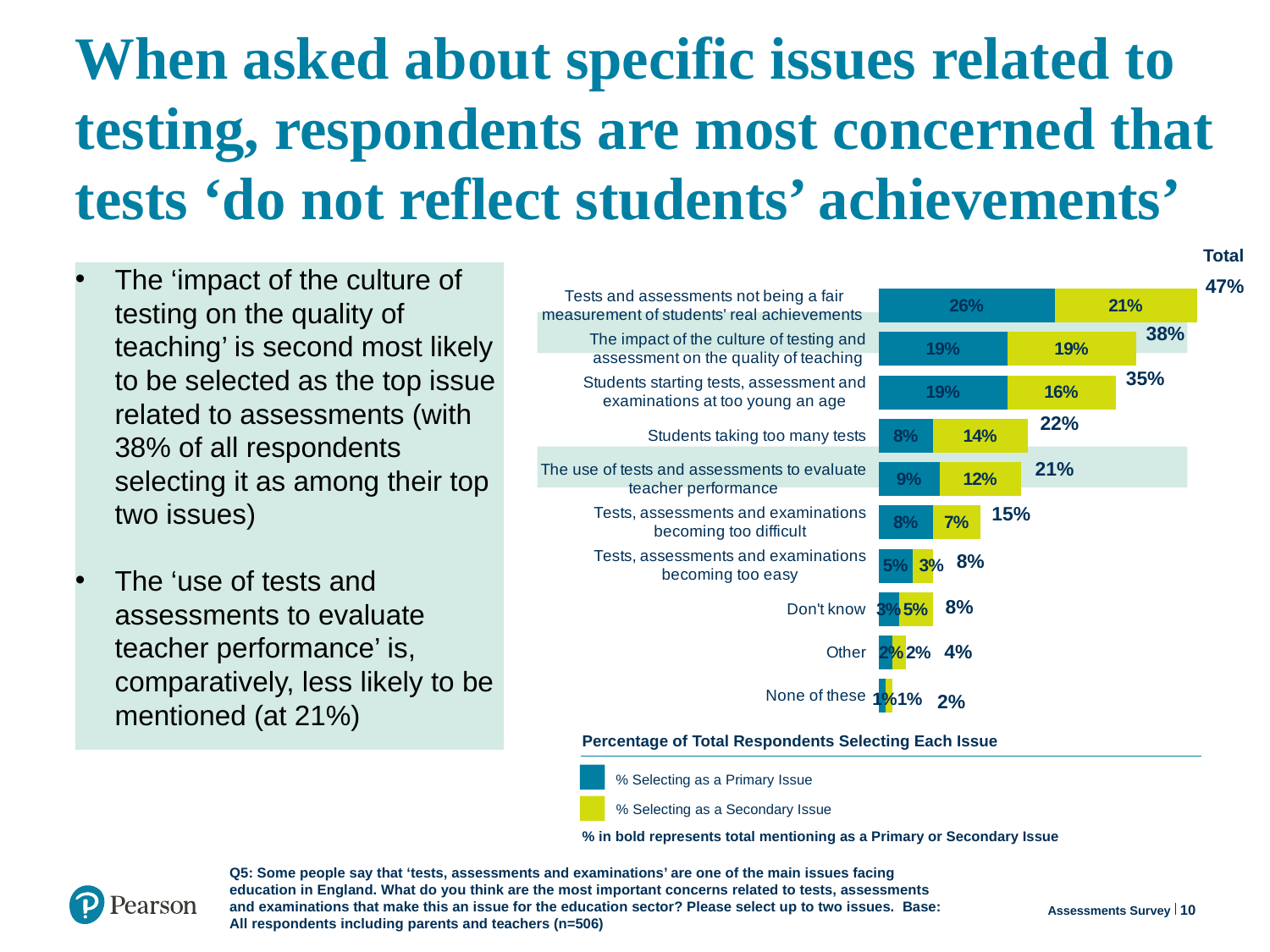
Which is larger: the Primary Issue percentage for 'Students taking too many tests' or for 'The use of tests and assessments to evaluate teacher performance'? The use of tests and assessments to evaluate teacher performance How many issue categories are plotted in the chart? 10 What percentage selected 'Tests and assessments not being a fair measurement of students' real achievements' as a Primary Issue? 26% What is the total percentage mentioning 'Students starting tests, assessment and examinations at too young an age' as a Primary or Secondary Issue? 35% What is the total of the stacked bar for 'Tests, assessments and examinations becoming too difficult'? 15% Which colour represents '% Selecting as a Secondary Issue' in the legend? Yellow-green What percentage selected 'Students taking too many tests' as a Secondary Issue? 14% What is the difference between the total for 'The impact of the culture of testing and assessment on the quality of teaching' and the total for 'The use of tests and assessments to evaluate teacher performance'? 17% How many series does the legend list? 2 Which issue has the highest total percentage of respondents selecting it? Tests and assessments not being a fair measurement of students' real achievements Which issue has the lowest total percentage of respondents selecting it? None of these What kind of chart is shown on the slide? Stacked bar chart